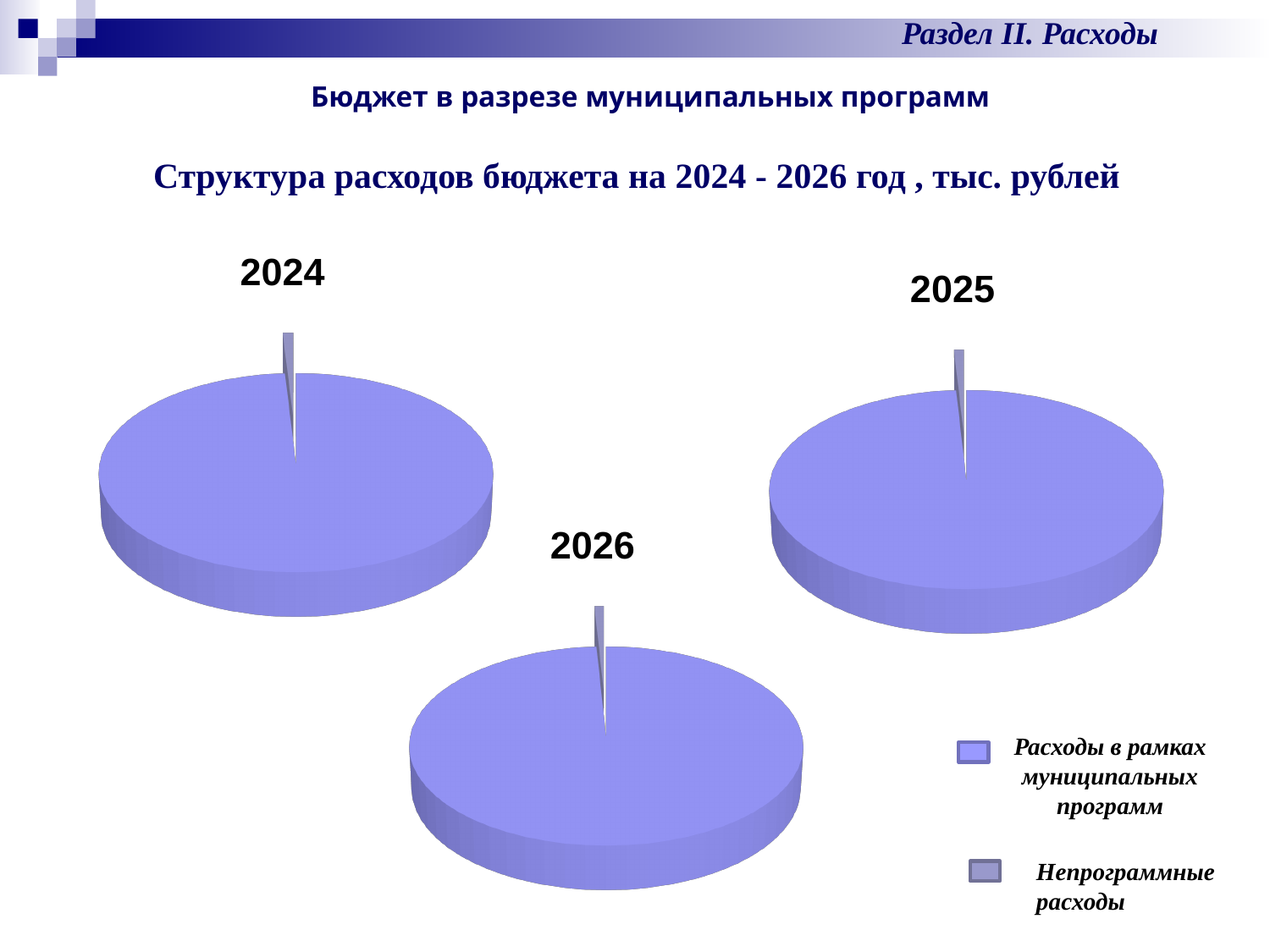
How many entries does the legend list? 2 In the 2024 pie chart, which slice is larger: Расходы в рамках муниципальных программ or Непрограммные расходы? Расходы в рамках муниципальных программ What is the title above the three pie charts? Структура расходов бюджета на 2024 - 2026 год , тыс. рублей What years are the three pie charts labelled with? 2024, 2025, 2026 In the 2026 pie chart, which slice is smaller: Расходы в рамках муниципальных программ or Непрограммные расходы? Непрограммные расходы How many slices does the 2025 pie chart have? 2 In the 2026 pie chart, which category has the largest slice? Расходы в рамках муниципальных программ In the 2025 pie chart, which category has the smallest slice? Непрограммные расходы How many pie charts are shown on the slide? 3 What kind of chart is used for the 2024 chart? pie chart